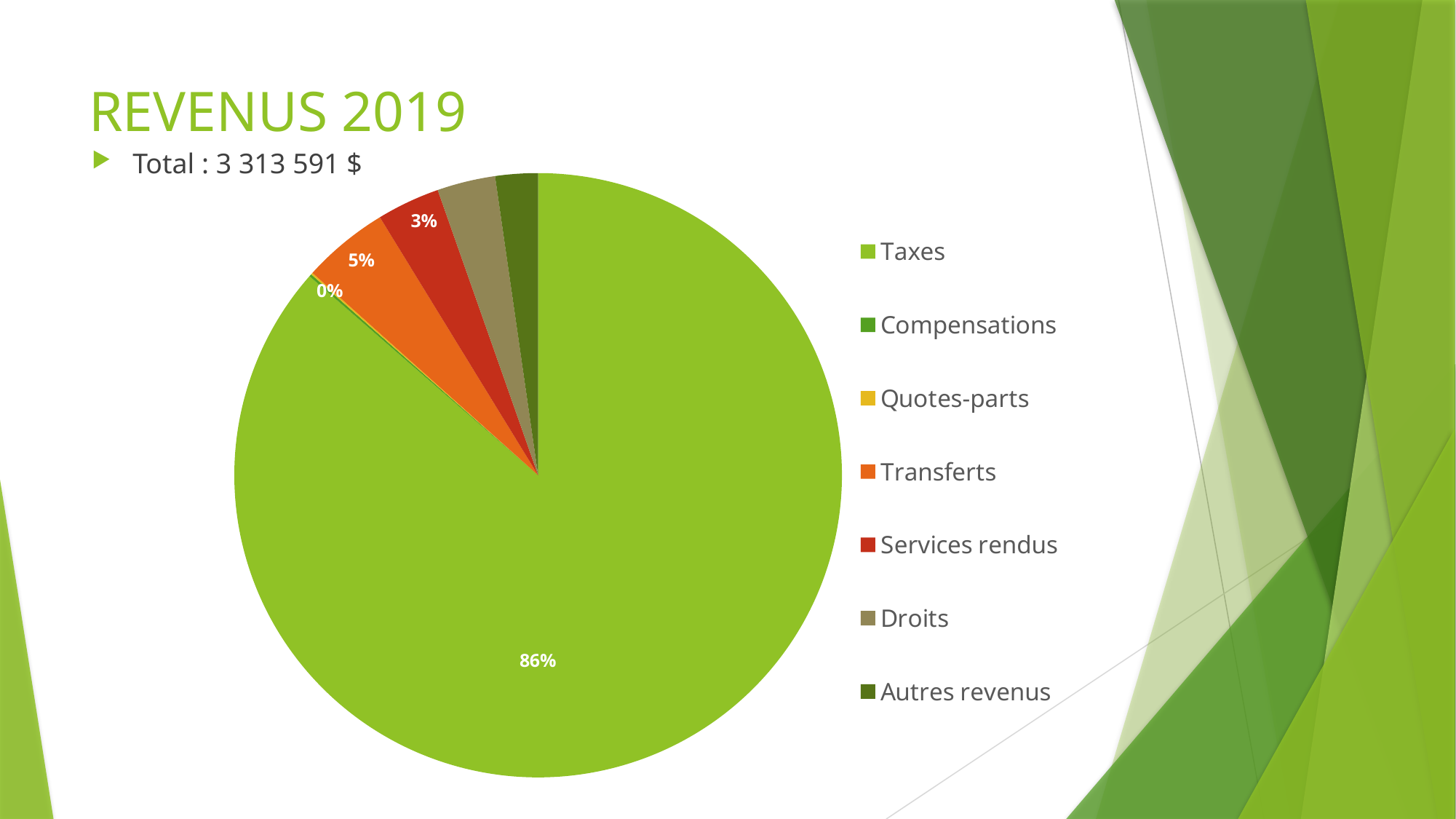
What is the difference between the Transferts and Services rendus percentages? 2% What kind of chart is shown on the slide? pie chart Which is larger, Taxes or Droits? Taxes What is the title of the slide containing the chart? REVENUS 2019 What total amount is stated above the chart? 3 313 591 $ What is the difference between the Taxes and Transferts percentages? 81% What is the value shown for Transferts? 5% What share of the pie does Taxes represent? 86% Which category has the largest slice of the pie? Taxes What is the value shown for Services rendus? 3% How many categories does the legend list? 7 Which is larger, Transferts or Services rendus? Transferts